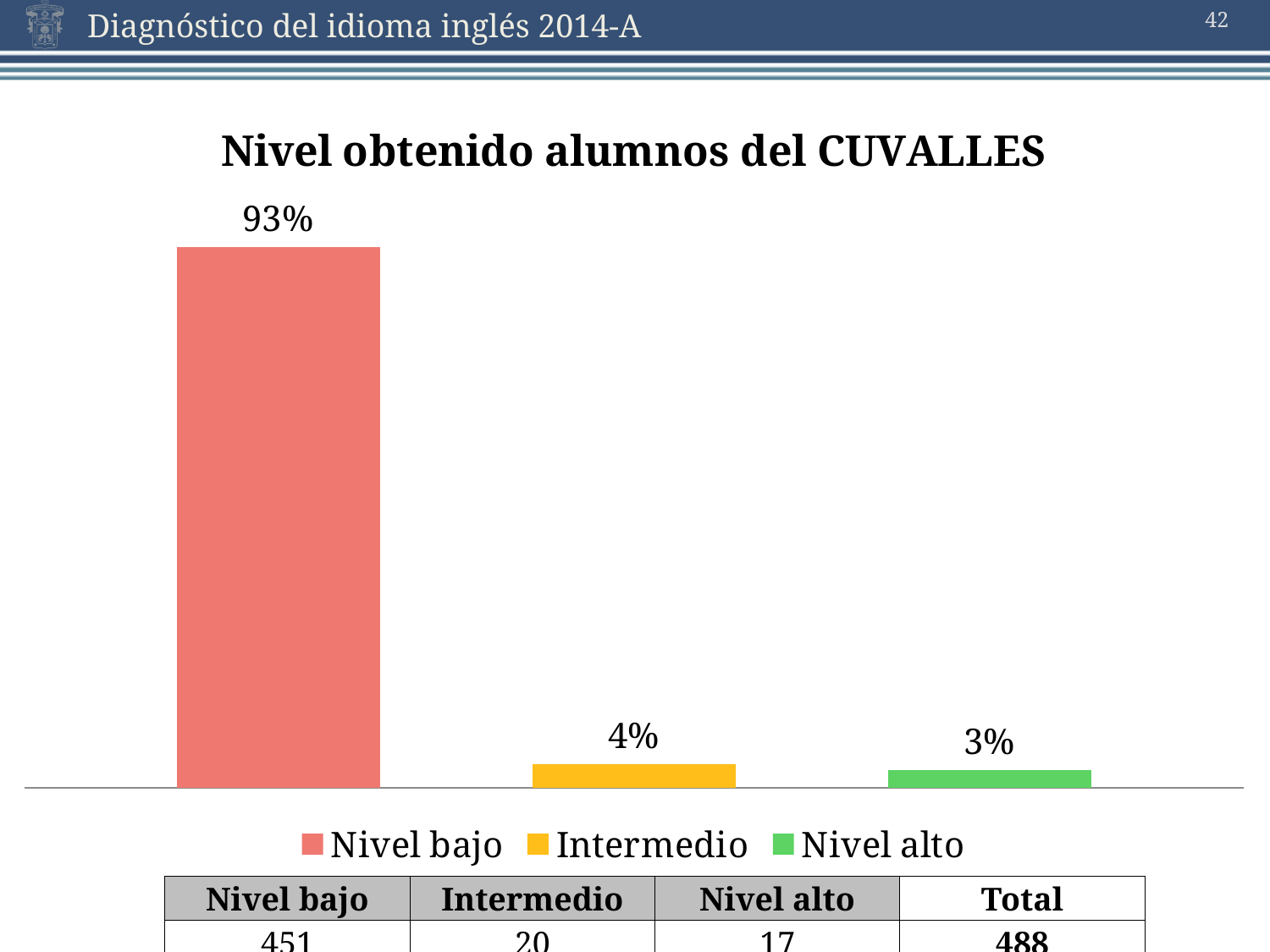
Which level has the lowest percentage? Nivel alto What percentage is shown for Nivel alto? 3% What is the difference in percentage points between Intermedio and Nivel alto? 1 What is the title of the chart? Nivel obtenido alumnos del CUVALLES How many entries does the legend list? 3 What is the difference in percentage points between Nivel bajo and Intermedio? 89 What percentage is shown for Nivel bajo? 93% How many bars are plotted in the chart? 3 Which is larger, the percentage for Nivel bajo or for Nivel alto? Nivel bajo What percentage is shown for Intermedio? 4% What kind of chart is shown on the slide? Bar chart Which level has the highest percentage? Nivel bajo